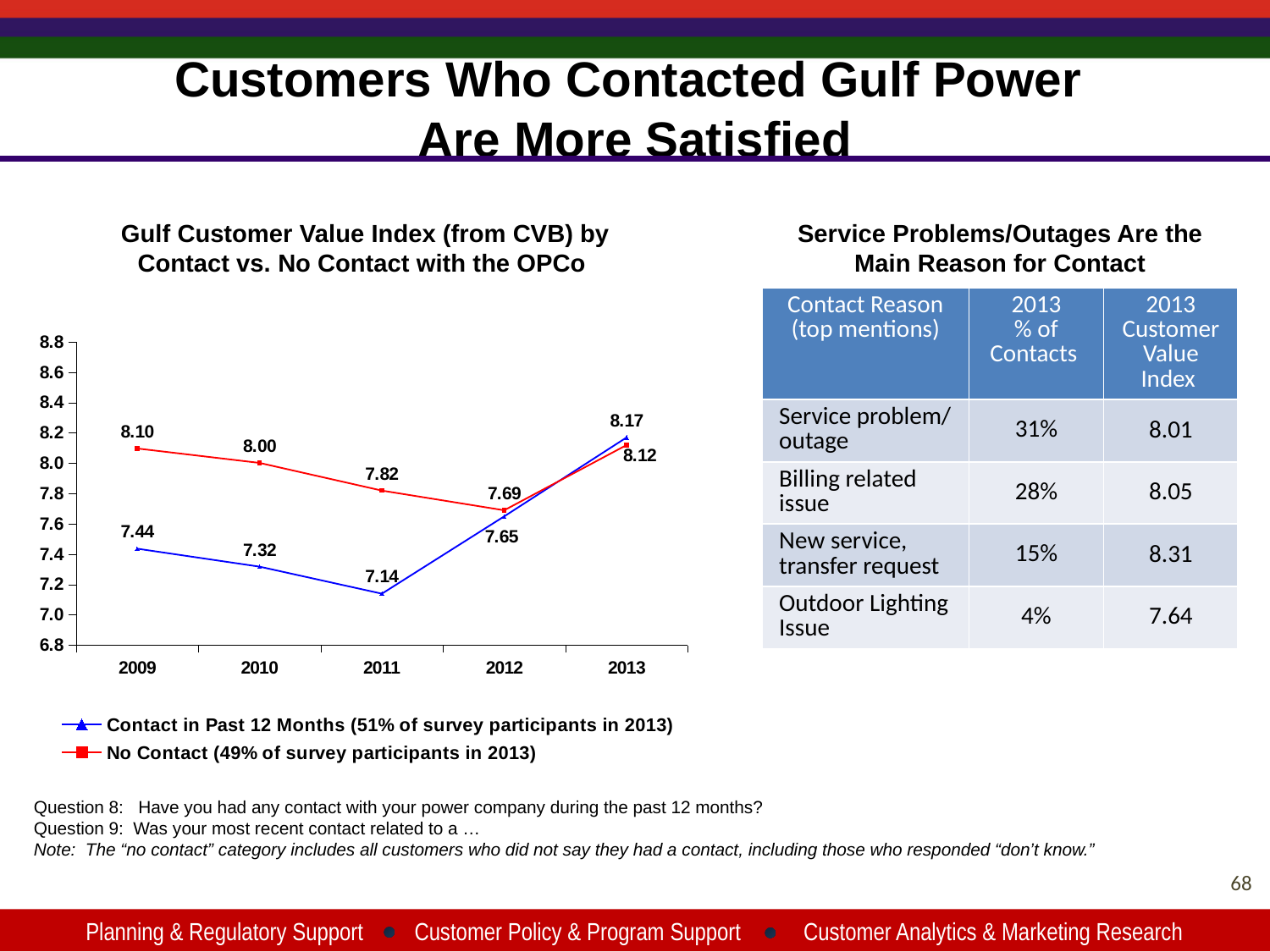
What was the Customer Value Index for Contact in Past 12 Months in 2013? 8.17 What is the difference between the No Contact and Contact in Past 12 Months values in 2009? 0.66 How many series does the chart legend list? 2 How many years are plotted on the x axis of the chart? 5 In which year was the No Contact series at its highest? 2013 What colour is the line for the No Contact series? red What was the Customer Value Index for No Contact in 2009? 8.10 What type of chart is shown on the slide? line chart Which series had the higher value in 2012, Contact in Past 12 Months or No Contact? No Contact In which year was the Contact in Past 12 Months series at its lowest? 2011 Did the No Contact series rise or fall from 2009 to 2012? fall What was the Customer Value Index for Contact in Past 12 Months in 2011? 7.14